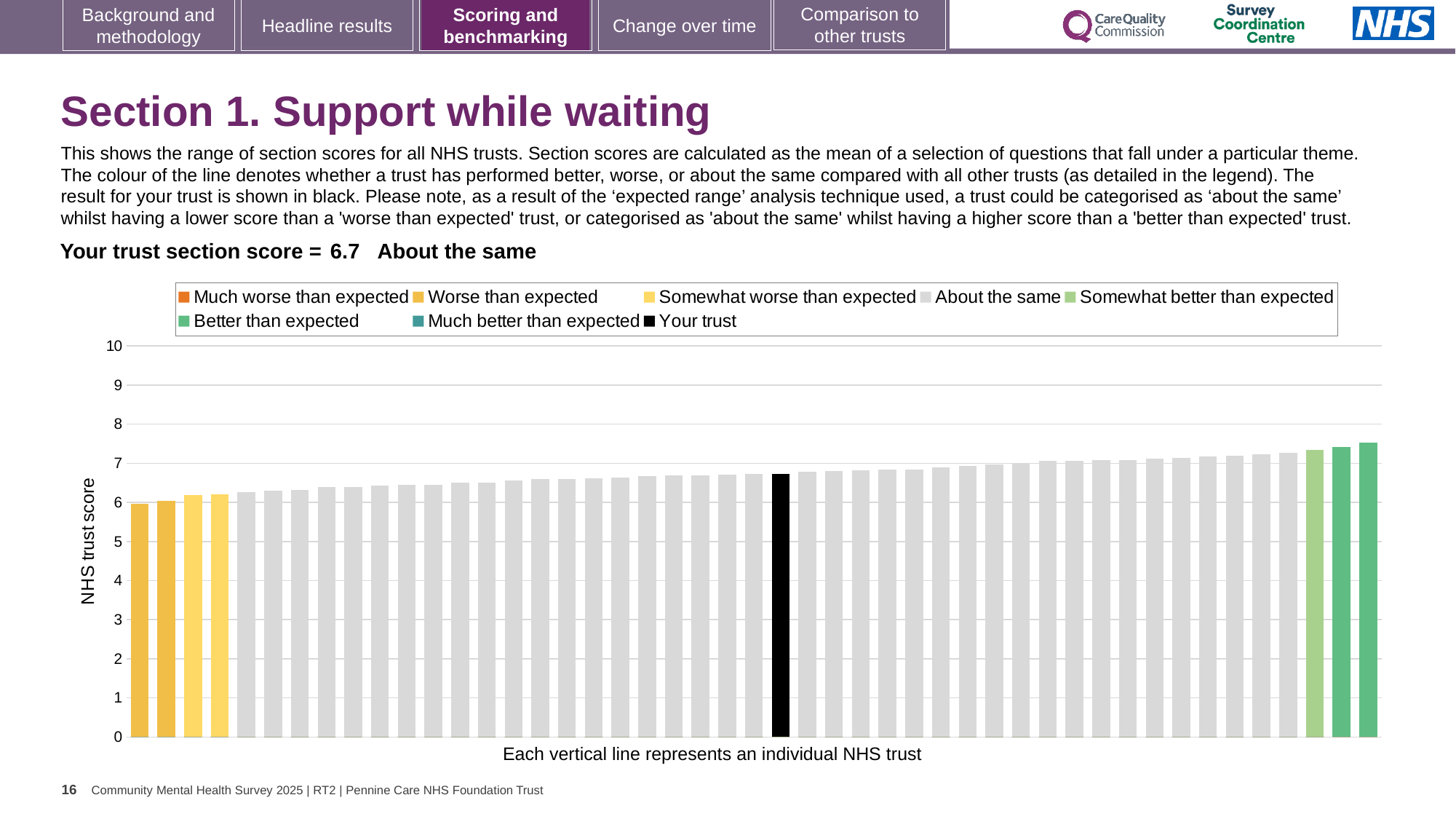
Is the value of the rightmost (highest) bar greater or less than 8? less How many entries does the chart legend list? 8 What is the trust section score shown on the slide? 6.7 Which is larger: the black 'Your trust' bar or the leftmost bar? the black 'Your trust' bar Which category is the trust's section score placed in? About the same Is the value of the leftmost (lowest) bar greater or less than 5? greater Is the value of the black 'Your trust' bar greater or less than 6? greater What is the title of the vertical axis? NHS trust score How many bars are coloured as 'Better than expected' (green)? 2 Do the bar values rise or fall from left to right along the x axis? rise What kind of chart is shown on the slide? bar chart